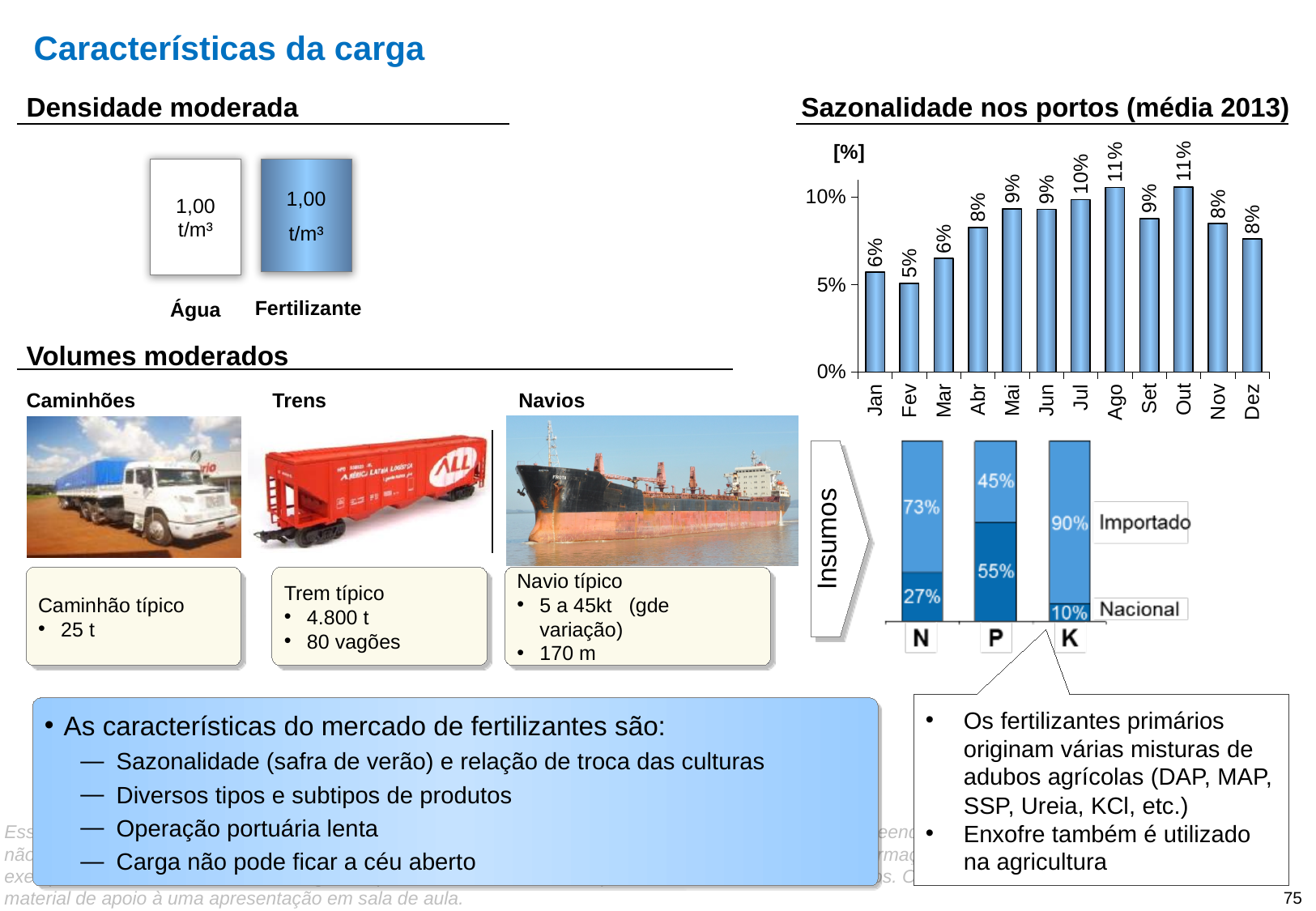
How many series does the legend of the 'Insumos' stacked bar chart list? 2 In the 'Insumos' stacked bar chart, what is the Nacional share for K? 10% In the 'Insumos' stacked bar chart, which input has the highest Importado share? K In the 'Sazonalidade nos portos (média 2013)' chart, what is the value for Fev? 5% In the 'Insumos' stacked bar chart, what is the Importado share for N? 73% In the 'Sazonalidade nos portos (média 2013)' chart, which month has the lowest value? Fev In the 'Sazonalidade nos portos (média 2013)' chart, what is the difference between the values for Ago and Fev? 6 percentage points In the 'Sazonalidade nos portos (média 2013)' chart, do the values rise or fall from Jan to Ago? Rise In the 'Sazonalidade nos portos (média 2013)' chart, how many months are plotted? 12 What kind of chart is 'Sazonalidade nos portos (média 2013)'? Bar chart In the 'Sazonalidade nos portos (média 2013)' chart, which is larger, the value for Jul or the value for Abr? Jul In the 'Sazonalidade nos portos (média 2013)' chart, what is the value for Ago? 11%